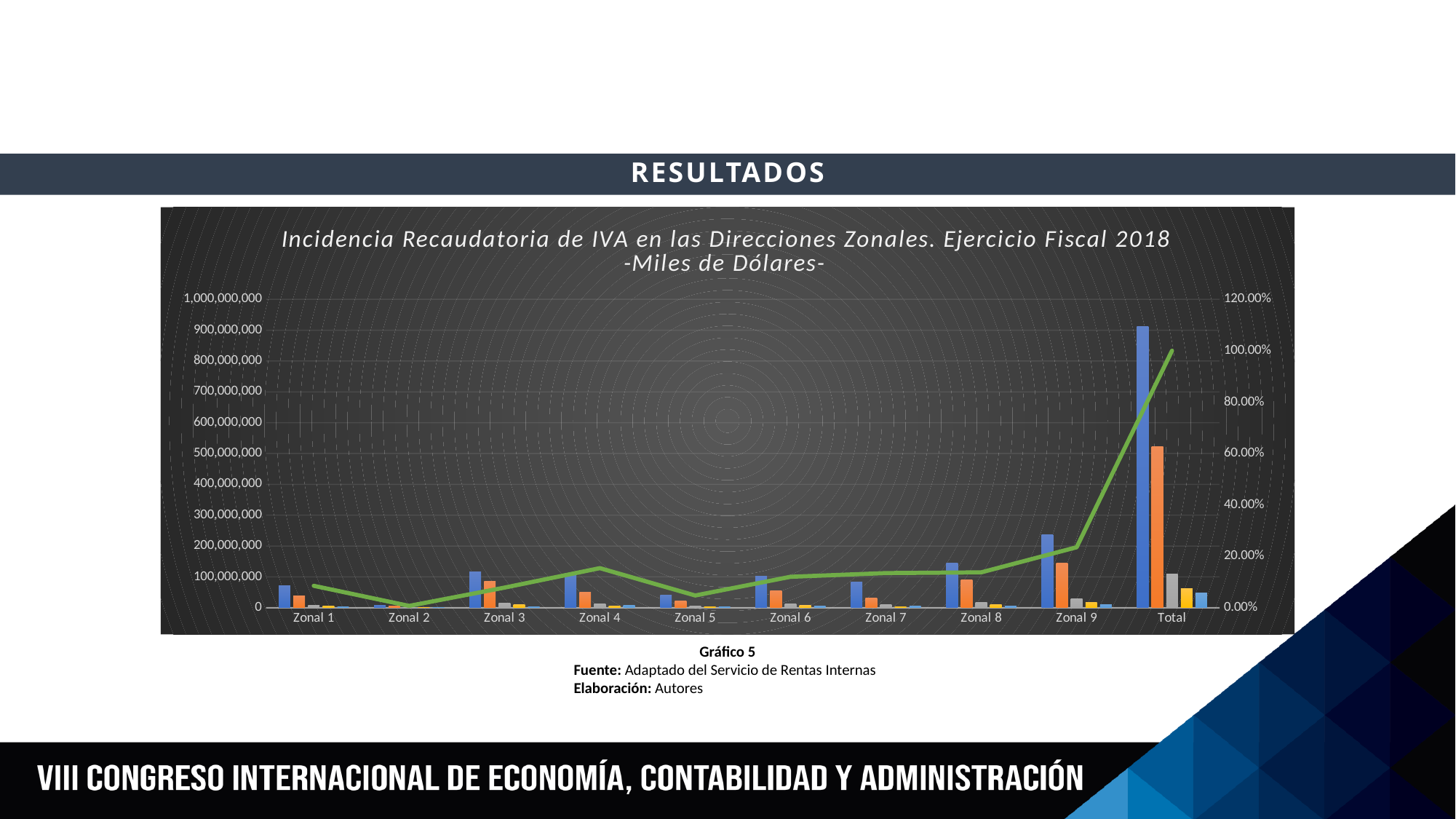
Is the green line value for Total greater or less than 80.00%? greater What kind of chart is shown on the slide? A bar chart combined with a line Does the green line rise or fall from Zonal 9 to Total? rise Is the blue bar for Zonal 9 greater or less than 200,000,000? greater Which category has the tallest blue bar? Total What is the title of the chart? Incidencia Recaudatoria de IVA en las Direcciones Zonales. Ejercicio Fiscal 2018 -Miles de Dólares- Is the blue bar for Total greater or less than 800,000,000? greater How many categories are shown on the x axis of the chart? 10 Among the Zonal categories (Zonal 1 to Zonal 9), which has the tallest blue bar? Zonal 9 Among the Zonal categories (Zonal 1 to Zonal 9), which has the shortest blue bar? Zonal 2 Which has the taller blue bar, Zonal 8 or Zonal 9? Zonal 9 At which category does the green line reach its lowest point? Zonal 2